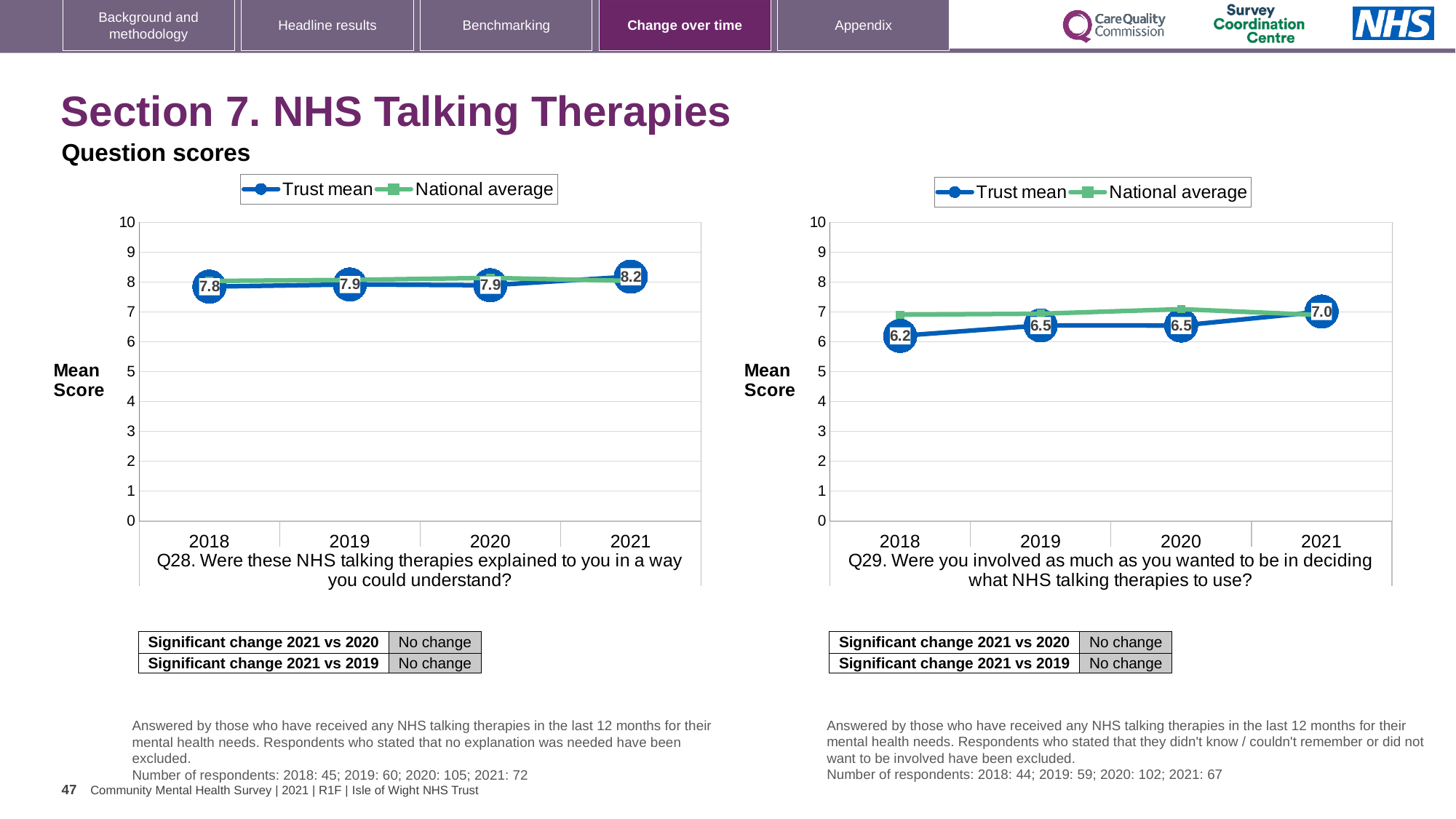
In the Q29 chart (right), which year has the lowest Trust mean score? 2018 In the Q29 chart (right), is the Trust mean score for 2018 greater or less than 7? less In the Q28 chart (left), what is the Trust mean score for 2021? 8.2 In the Q29 chart (right), what is the Trust mean score for 2018? 6.2 In the Q29 chart (right), which year has the highest Trust mean score? 2021 In the Q29 chart (right), what is the difference between the Trust mean scores for 2021 and 2020? 0.5 In the Q28 chart (left), what is the Trust mean score for 2018? 7.8 What type of chart is used for Q28 (left)? Line chart How many years are shown on the x axis of the Q28 chart (left)? 4 In the Q28 chart (left), what is the difference between the Trust mean scores for 2021 and 2018? 0.4 How many series does the legend of the Q29 chart (right) list? 2 In the Q29 chart (right), what is the Trust mean score for 2021? 7.0